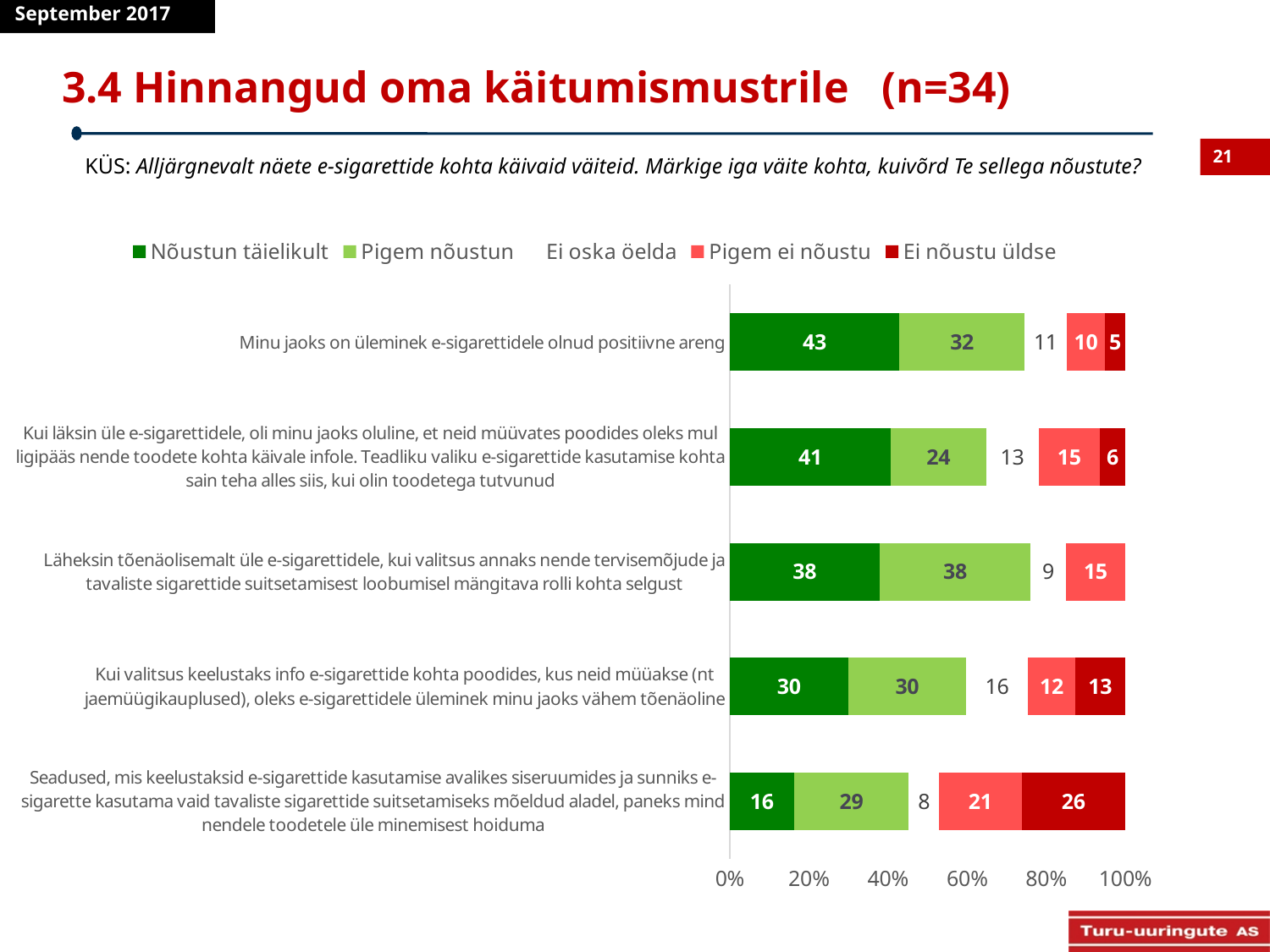
What is the 'Nõustun täielikult' value for the statement 'Minu jaoks on üleminek e-sigarettidele olnud positiivne areng'? 43 How many statements (categories) are plotted in the chart? 5 What is the 'Ei nõustu üldse' value for the statement beginning 'Seadused, mis keelustaksid e-sigarettide kasutamise avalikes siseruumides'? 26 What is the difference between the 'Nõustun täielikult' values for 'Minu jaoks on üleminek e-sigarettidele olnud positiivne areng' (43) and the statement beginning 'Seadused, mis keelustaksid' (16)? 27 What kind of chart is shown on the slide? stacked bar chart How many series does the legend list? 5 What is the 'Pigem ei nõustu' value for the statement beginning 'Kui valitsus keelustaks info e-sigarettide kohta poodides'? 12 What is the total of the printed values in the bar for the statement beginning 'Seadused, mis keelustaksid e-sigarettide kasutamise avalikes siseruumides'? 100 For the statement beginning 'Kui läksin üle e-sigarettidele', which is larger: the 'Pigem nõustun' value or the 'Pigem ei nõustu' value? Pigem nõustun Which legend entry is shown in dark red? Ei nõustu üldse Which statement has the highest 'Nõustun täielikult' value? Minu jaoks on üleminek e-sigarettidele olnud positiivne areng